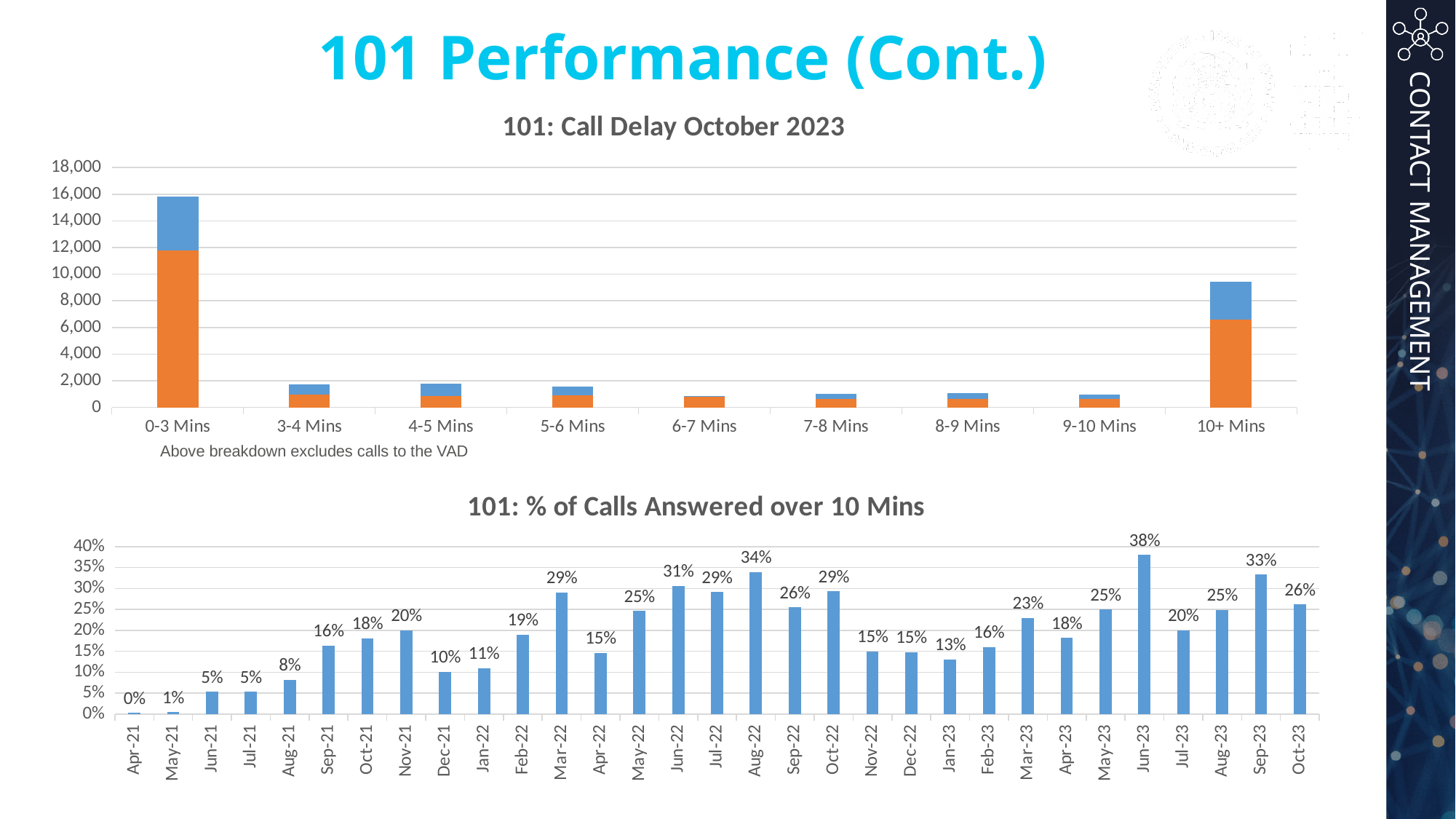
In the chart titled '101: % of Calls Answered over 10 Mins', what is the value for Jun-23? 38% In the chart titled '101: % of Calls Answered over 10 Mins', what is the value for Oct-23? 26% In the chart titled '101: % of Calls Answered over 10 Mins', which month has the lowest value? Apr-21 In the chart titled '101: Call Delay October 2023', how many delay categories are shown on the x axis? 9 In the chart titled '101: % of Calls Answered over 10 Mins', what is the difference between the values for Sep-23 and Oct-23? 7% In the chart titled '101: Call Delay October 2023', which category has the tallest bar? 0-3 Mins In the chart titled '101: % of Calls Answered over 10 Mins', which is larger, the value for Aug-22 or the value for Mar-22? Aug-22 What kind of chart is the chart titled '101: Call Delay October 2023'? Stacked bar chart In the chart titled '101: % of Calls Answered over 10 Mins', how many months are plotted? 31 In the chart titled '101: Call Delay October 2023', is the total value for 6-7 Mins greater or less than 2,000? less In the chart titled '101: Call Delay October 2023', is the total value for 10+ Mins greater or less than 8,000? greater In the chart titled '101: % of Calls Answered over 10 Mins', which month has the highest value? Jun-23